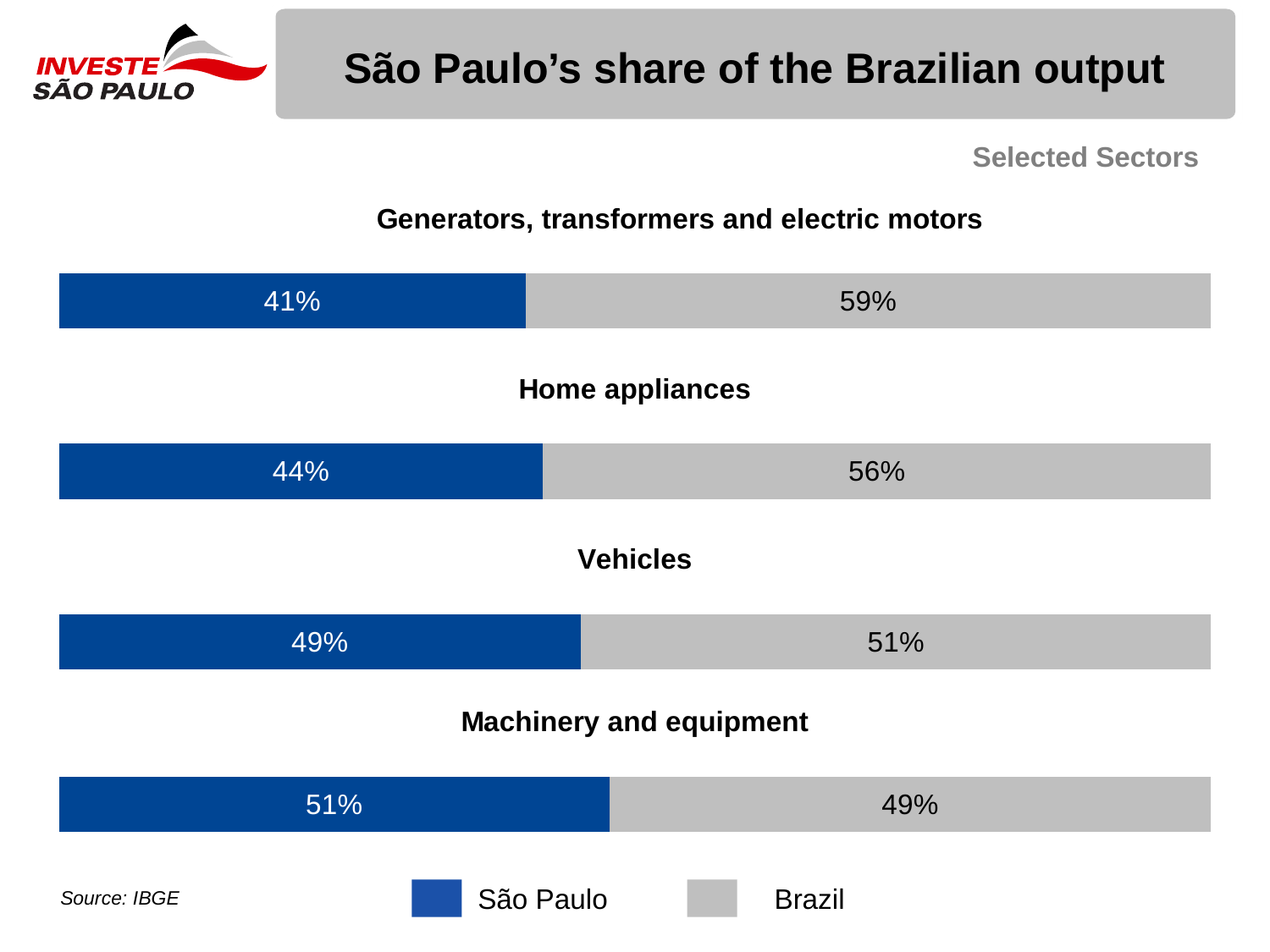
What is Brazil's share for Machinery and equipment? 49% In which sector is São Paulo's share the lowest? Generators, transformers and electric motors What kind of chart is used on the slide? Stacked bar chart What is the difference between Brazil's share and São Paulo's share for Generators, transformers and electric motors? 18 percentage points What is Brazil's share for Home appliances? 56% How many sectors are shown on the slide? 4 In which sector is São Paulo's share the highest? Machinery and equipment Which colour represents São Paulo in the legend? Blue For Home appliances, which is larger: São Paulo's share or Brazil's share? Brazil's share What is São Paulo's share for Generators, transformers and electric motors? 41% What is São Paulo's share for Vehicles? 49% How many series does the legend list? 2